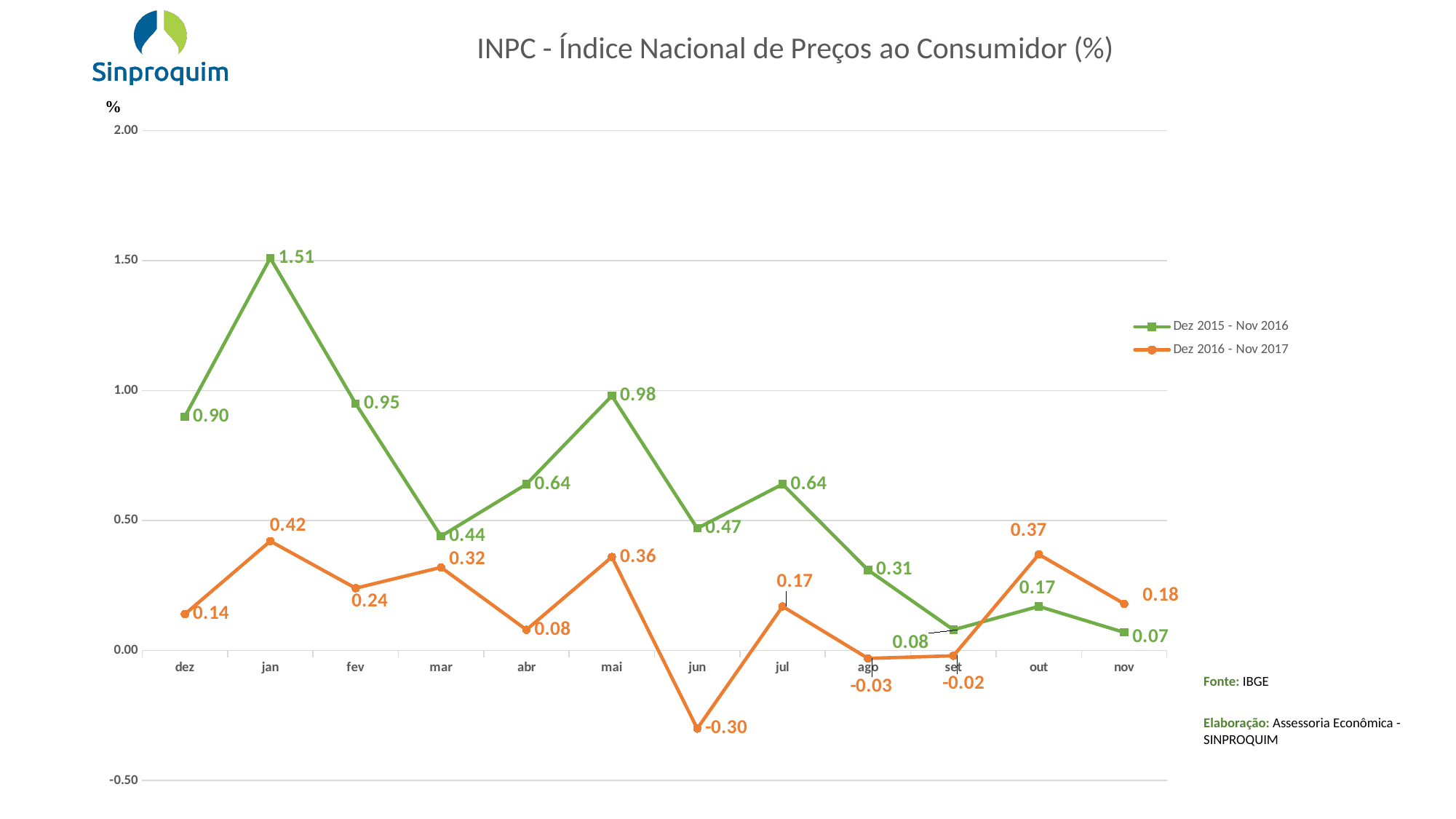
Which month has the lowest value in the Dez 2016 - Nov 2017 series? jun How many series does the legend list? 2 What is the value for jan in the Dez 2015 - Nov 2016 series? 1.51 What colour is the line for the Dez 2016 - Nov 2017 series? orange From jul to nov, does the Dez 2015 - Nov 2016 series generally rise or fall? fall How many months are plotted along the x axis? 12 Which month has the highest value in the Dez 2015 - Nov 2016 series? jan For out, which series has the larger value, Dez 2015 - Nov 2016 or Dez 2016 - Nov 2017? Dez 2016 - Nov 2017 Is the value for fev in the Dez 2015 - Nov 2016 series greater or less than 0.50? greater What type of chart is shown on the slide? line chart What is the value for jun in the Dez 2016 - Nov 2017 series? -0.30 What is the difference between the Dez 2015 - Nov 2016 and Dez 2016 - Nov 2017 values for mai? 0.62